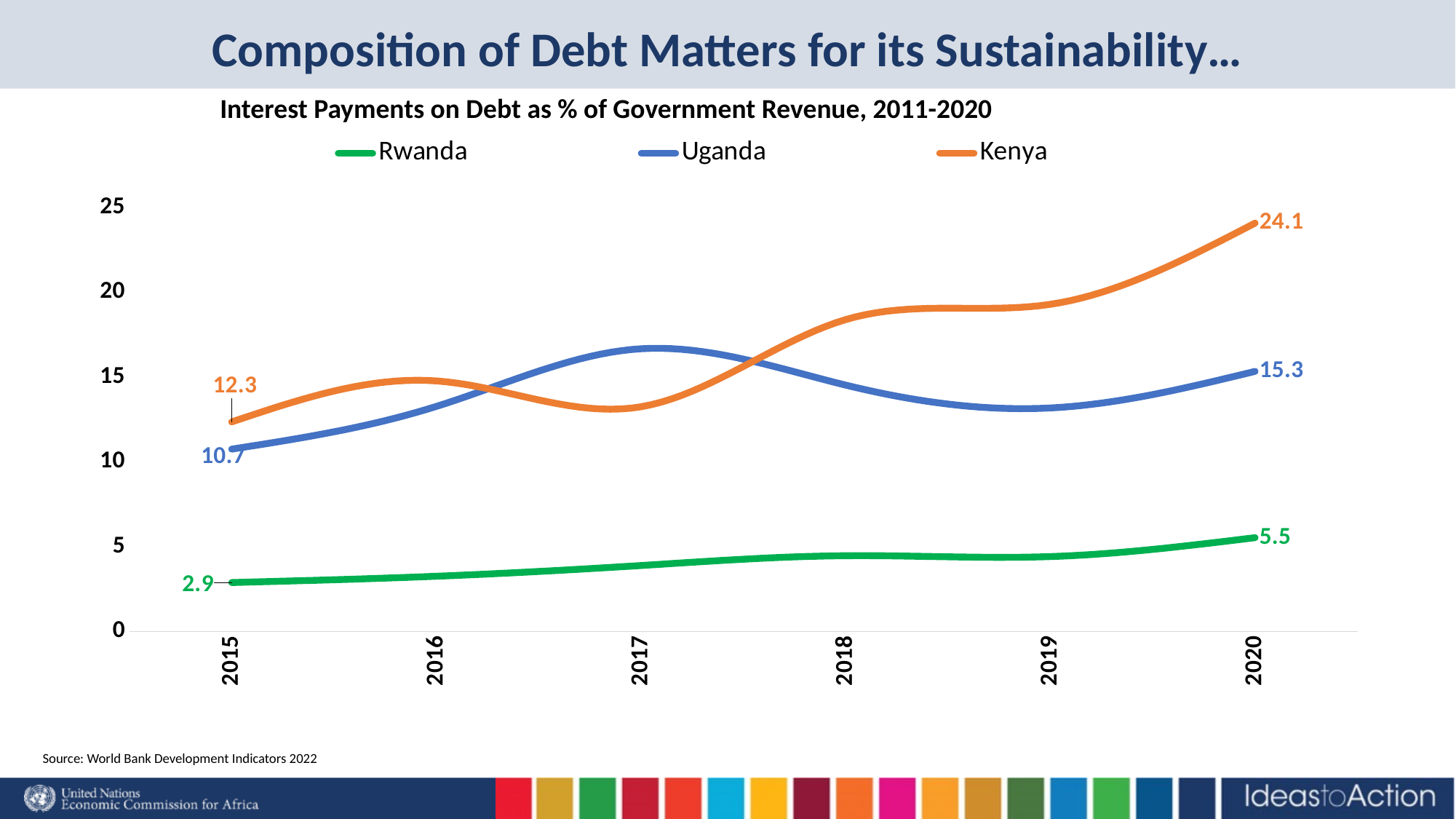
Which is larger in 2017: the value for Uganda or the value for Kenya? Uganda What kind of chart is shown on the slide? Line chart What is the value for Uganda in 2015? 10.7 Is the value for Kenya in 2018 greater or less than 15? greater What is the value for Rwanda in 2020? 5.5 What is the value for Kenya in 2020? 24.1 What is the difference between Kenya's and Uganda's values in 2020? 8.7 Which country has the highest value in 2020? Kenya What is the value for Kenya in 2015? 12.3 Which country has the lowest value in 2015? Rwanda How many series does the legend list? 3 By how much did Rwanda's value change from 2015 to 2020? 2.6